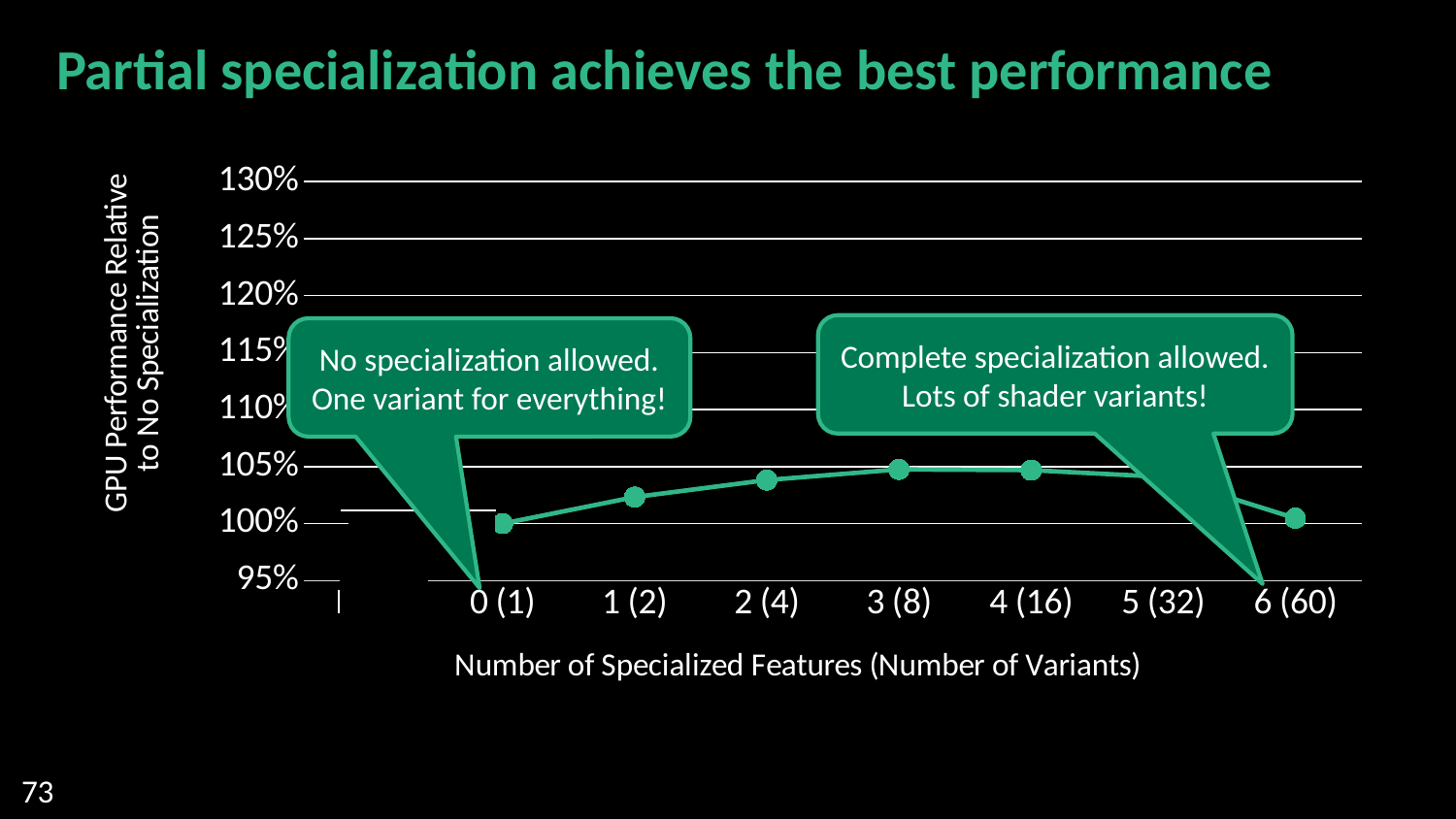
Do the values rise or fall from 0 (1) to 3 (8)? rise Which has the higher GPU performance, 3 (8) or 1 (2)? 3 (8) Which has the higher GPU performance, 4 (16) or 6 (60)? 4 (16) Is the value for 6 (60) greater or less than 105%? less What kind of chart is shown on the slide? line chart Is the value for 3 (8) greater or less than 110%? less Is the value for 2 (4) greater or less than 100%? greater Do the values rise or fall from 4 (16) to 6 (60)? fall What is the label of the x axis? Number of Specialized Features (Number of Variants) How many x-axis categories (numbers of specialized features) are labelled on the chart? 7 What is the title of the slide? Partial specialization achieves the best performance